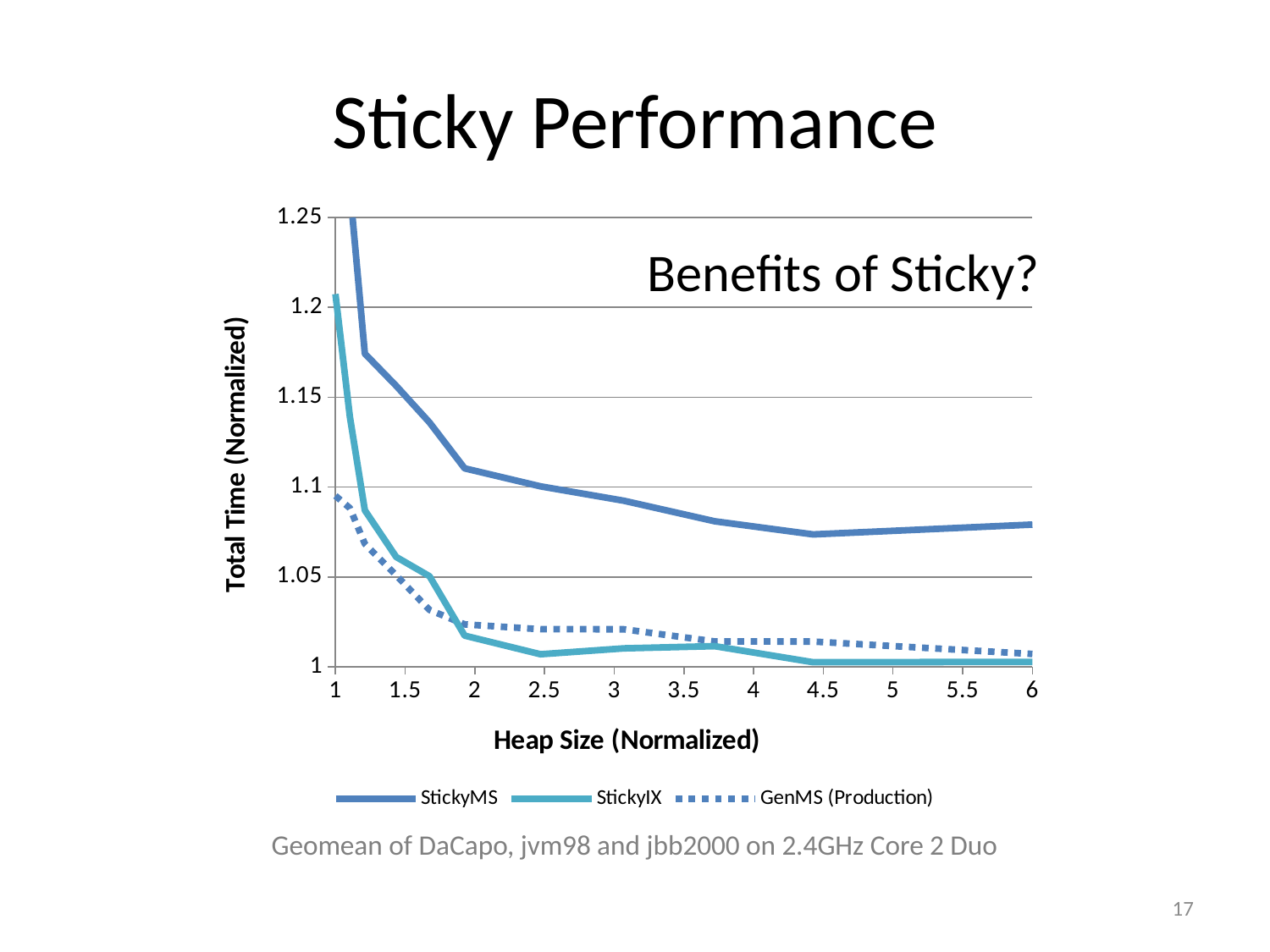
Which series is drawn with a dotted line? GenMS (Production) Is the value for StickyIX at heap size 6 greater or less than 1.05? less Is the value for StickyIX at heap size 1 greater or less than 1.15? greater What kind of chart is shown on the slide? line chart At heap size 6, which series has the larger value, StickyMS or StickyIX? StickyMS Does the StickyMS line rise or fall as heap size increases from 1 to 6? fall How many series does the legend list? 3 Is the value for StickyMS at heap size 6 greater or less than 1.05? greater At heap size 3, which series has the larger value, StickyMS or GenMS (Production)? StickyMS At heap size 5, which series has the larger value, GenMS (Production) or StickyIX? GenMS (Production) What is the label of the y axis? Total Time (Normalized)